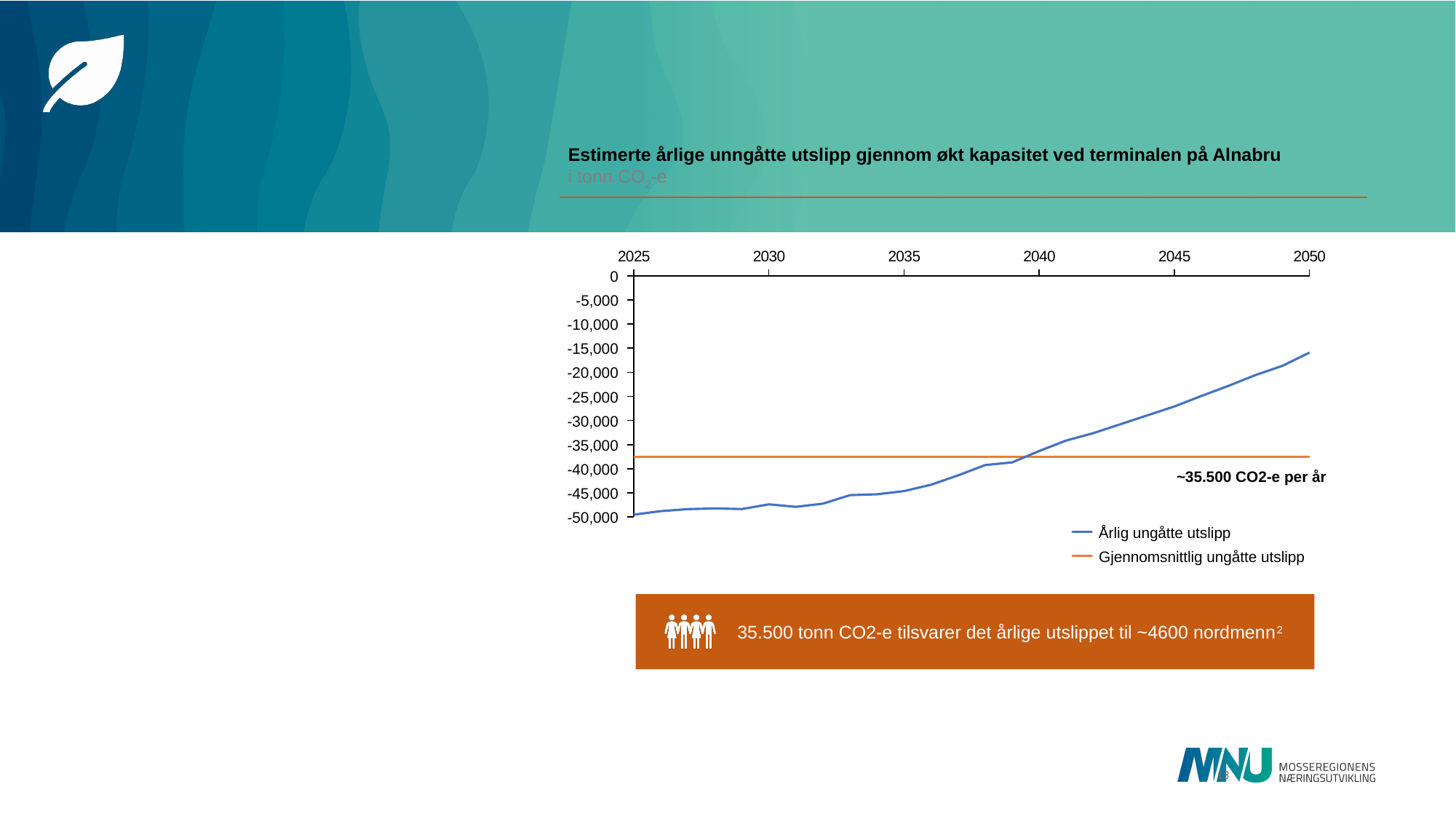
Which is larger, the 'Årlig ungåtte utslipp' value in 2050 or in 2025? 2050 Is the 'Årlig ungåtte utslipp' value for 2025 greater or less than -45,000? less What is the title of the chart? Estimerte årlige unngåtte utslipp gjennom økt kapasitet ved terminalen på Alnabru How many year labels are shown on the x axis of the chart? 6 In which year does the 'Årlig ungåtte utslipp' line reach its highest value? 2050 What kind of chart is shown on the slide? line chart Does the blue 'Årlig ungåtte utslipp' line rise or fall from 2025 to 2050? rises What label is printed next to the orange horizontal line in the chart? ~35.500 CO2-e per år How many series does the chart legend list? 2 Is the 'Årlig ungåtte utslipp' value for 2035 greater or less than -40,000? less Is the 'Årlig ungåtte utslipp' value for 2050 greater or less than -20,000? greater In which year does the 'Årlig ungåtte utslipp' line have its lowest value? 2025